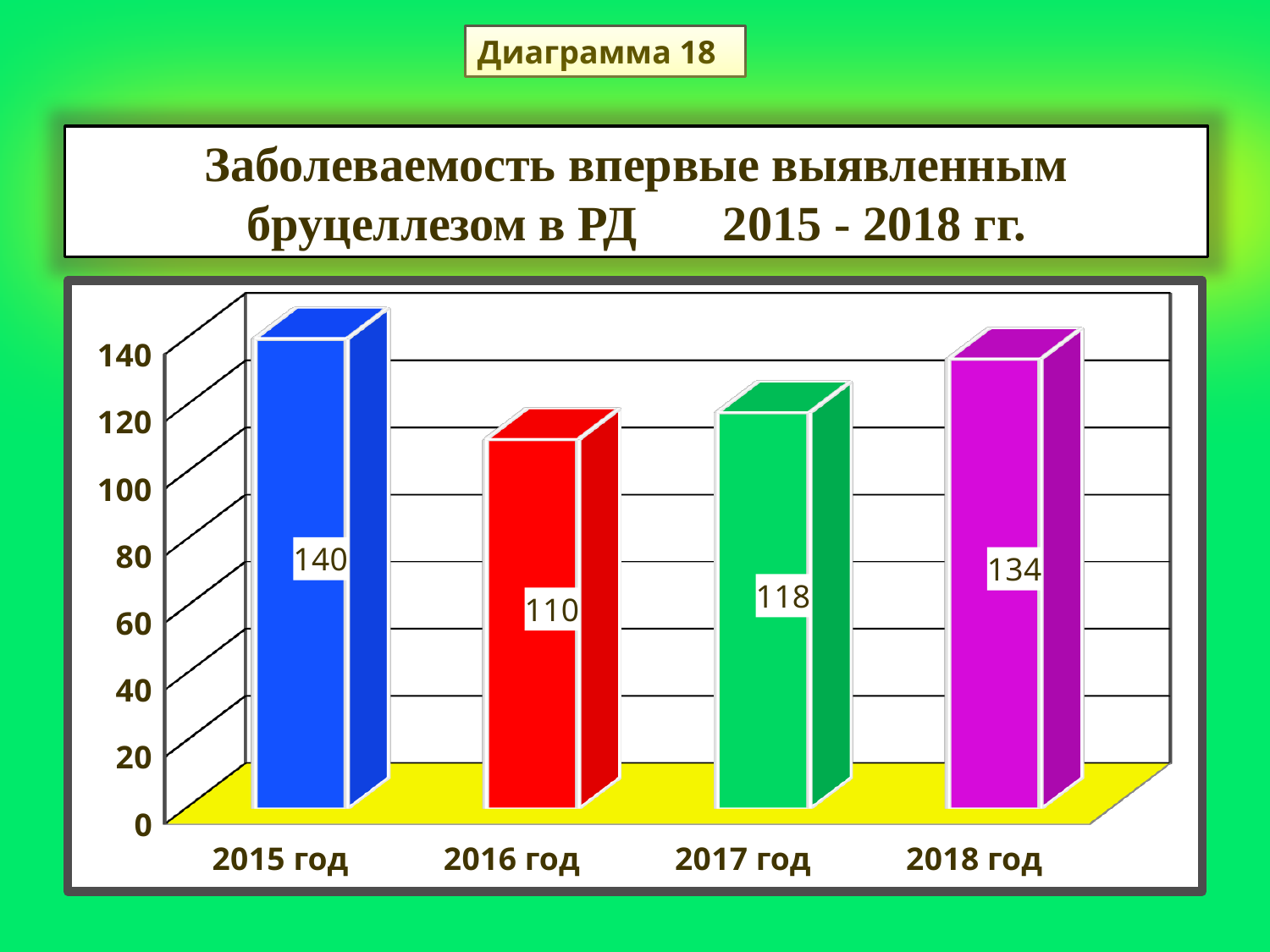
Which year has the lowest value? 2016 год What is the value for 2018 год? 134 What is the value for 2016 год? 110 What is the difference between the values for 2018 год and 2017 год? 16 What is the title of the chart? Заболеваемость впервые выявленным бруцеллезом в РД 2015 - 2018 гг. What is the value for 2017 год? 118 Which year has the highest value? 2015 год What is the difference between the values for 2015 год and 2016 год? 30 What is the value for 2015 год? 140 What kind of chart is shown on the slide? bar chart Which is larger, the value for 2017 год or the value for 2018 год? 2018 год How many years are shown on the chart? 4